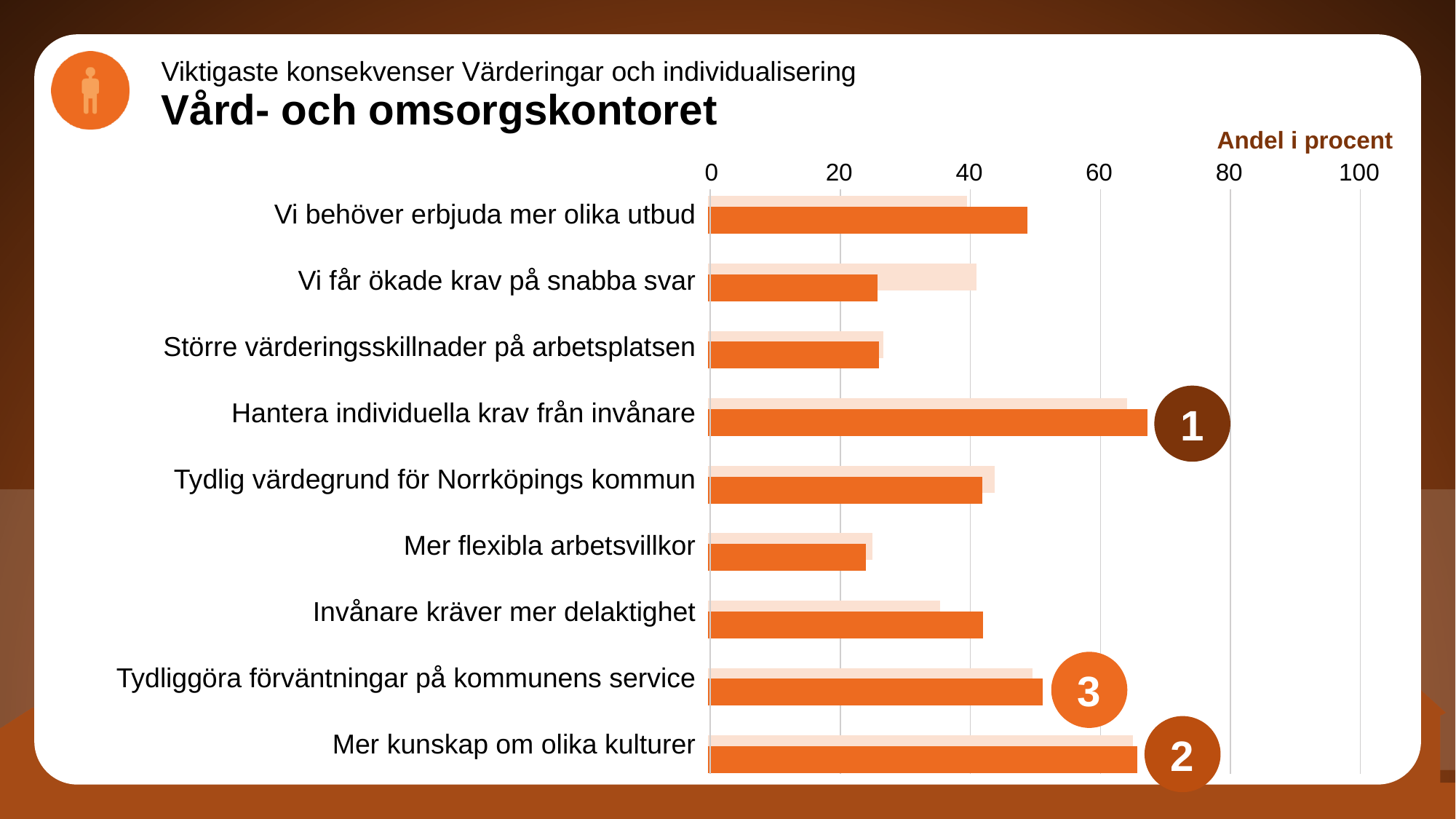
Is the dark orange bar for 'Mer kunskap om olika kulturer' greater or less than 60? greater Is the dark orange bar for 'Mer flexibla arbetsvillkor' greater or less than 40? less Which category is marked with the circled number 2? Mer kunskap om olika kulturer Which has the longer dark orange bar: 'Hantera individuella krav från invånare' or 'Mer flexibla arbetsvillkor'? Hantera individuella krav från invånare Which category has the longest dark orange bar? Hantera individuella krav från invånare How many categories are plotted in the chart? 9 Which has the longer dark orange bar: 'Vi behöver erbjuda mer olika utbud' or 'Vi får ökade krav på snabba svar'? Vi behöver erbjuda mer olika utbud Is the dark orange bar for 'Vi får ökade krav på snabba svar' greater or less than 40? less What label is shown above the horizontal axis of the chart? Andel i procent What kind of chart is shown on the slide? bar chart